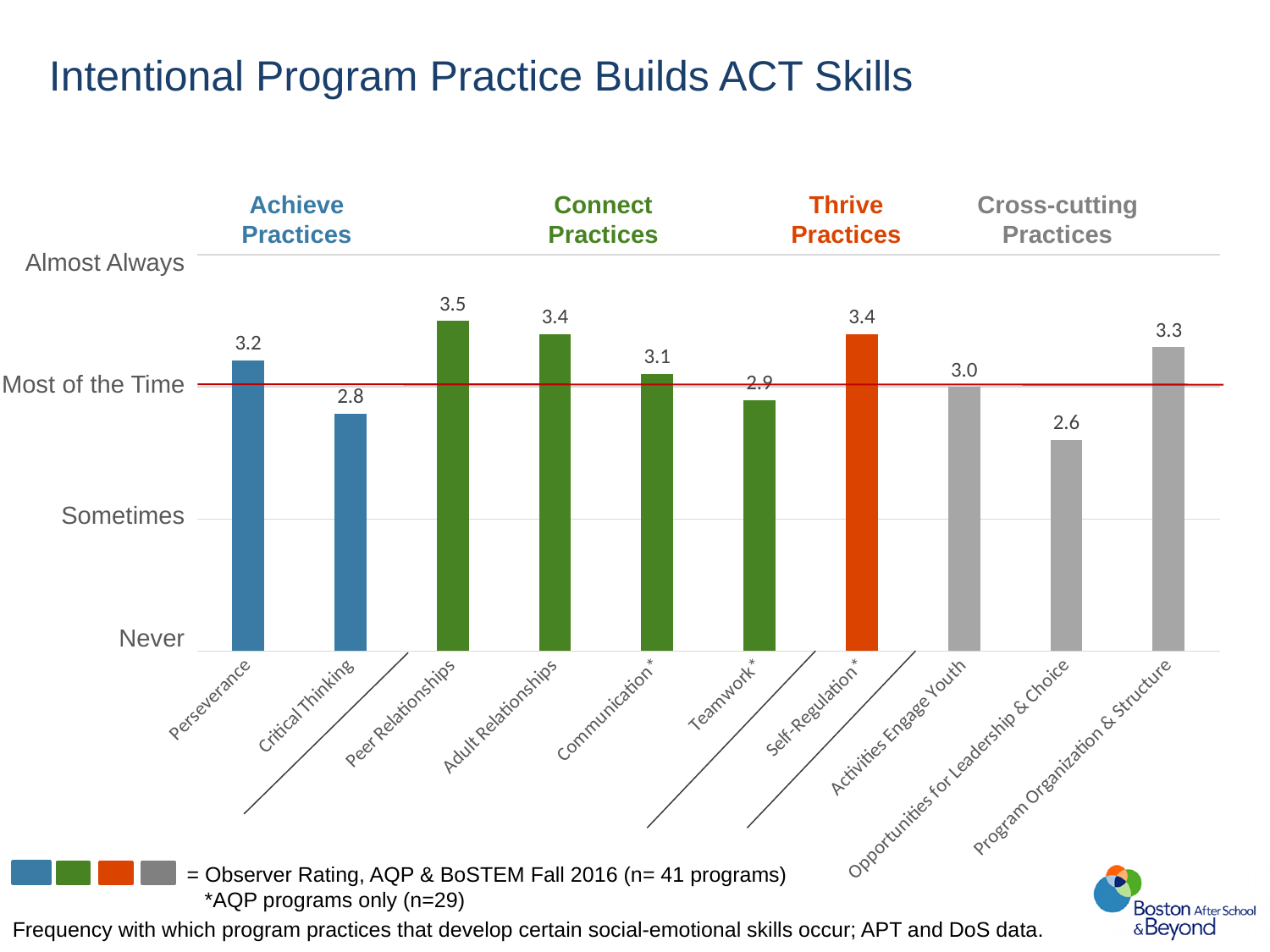
Which practice group is shown in orange? Thrive Practices What is the value for Program Organization & Structure? 3.3 Which category has the lowest value? Opportunities for Leadership & Choice What is the value for Opportunities for Leadership & Choice? 2.6 Which is larger, the value for Communication* or the value for Teamwork*? Communication* What is the value for Self-Regulation*? 3.4 What is the difference between the values for Peer Relationships and Critical Thinking? 0.7 What is the value for Perseverance? 3.2 Which category has the highest value? Peer Relationships What kind of chart is shown on the slide? Bar chart Which y-axis label does the red horizontal line correspond to? Most of the Time How many categories are shown on the x axis? 10